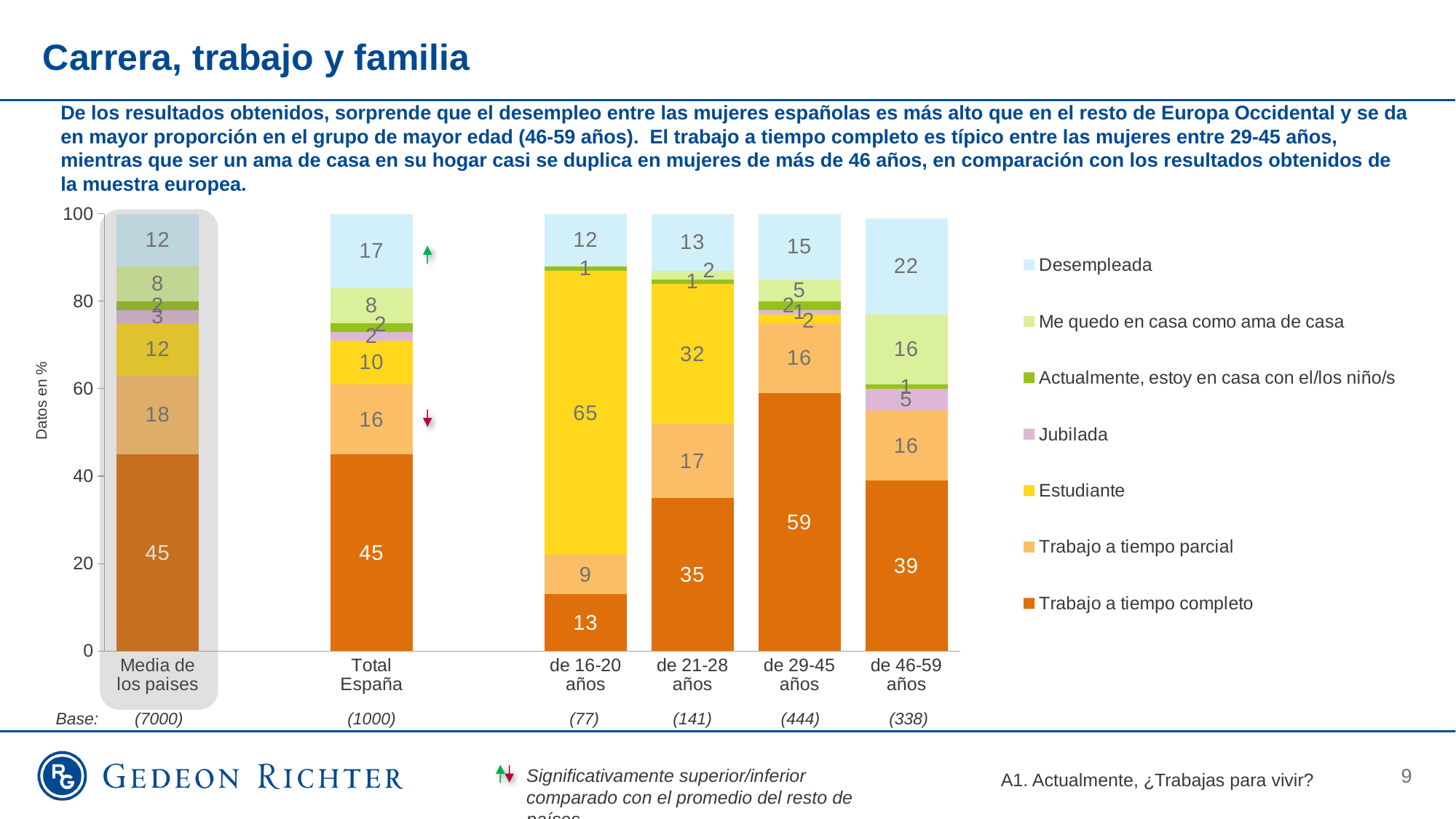
Which category has the lowest value for Trabajo a tiempo completo? de 16-20 años What is the value for Me quedo en casa como ama de casa in the 'de 46-59 años' bar? 16 What is the value for Desempleada in the 'de 46-59 años' bar? 22 Which series is listed first (at the top) in the legend? Desempleada What is the value for Trabajo a tiempo completo in the 'de 29-45 años' bar? 59 What is the value for Estudiante in the 'de 16-20 años' bar? 65 Which category has the highest value for Trabajo a tiempo completo? de 29-45 años What kind of chart is shown on the slide? Stacked bar chart How many series does the legend list? 7 How many categories (bars) are plotted along the x axis? 6 What is the difference between the Desempleada value for Total España and for Media de los paises? 5 Which has the larger Trabajo a tiempo parcial value, Media de los paises or Total España? Media de los paises